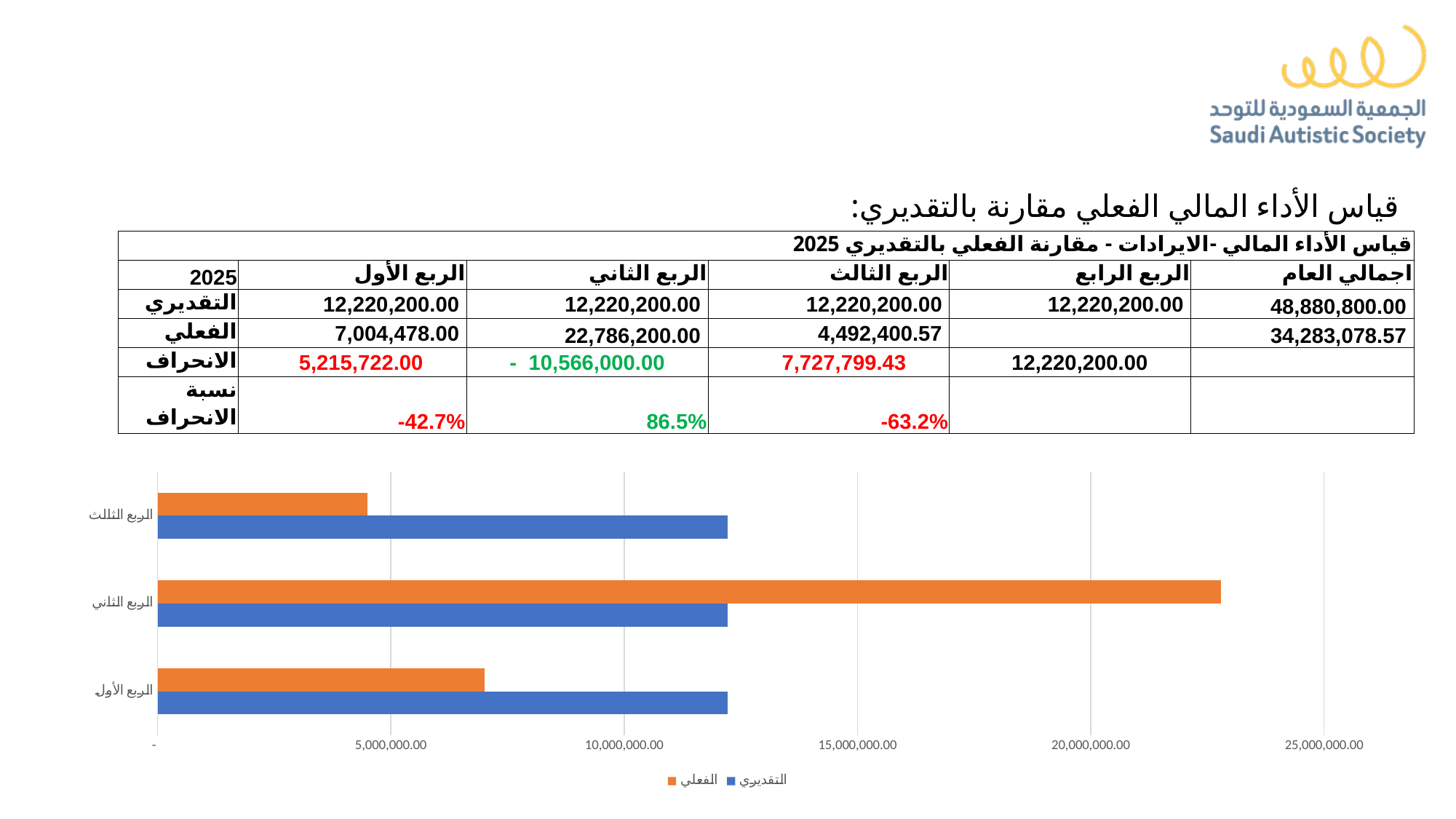
Is the الفعلي value for الربع الثالث greater or less than 5,000,000.00? less How many series does the chart legend list? 2 Is the الفعلي value for الربع الثاني greater or less than 20,000,000.00? greater How many quarters (categories) are plotted on the chart? 3 For الربع الثاني, which is larger: التقديري or الفعلي? الفعلي What is the التقديري (estimated) value for الربع الأول? 12,220,200.00 What kind of chart is shown on the slide? bar chart For الربع الأول, which is larger: التقديري or الفعلي? التقديري Which quarter has the highest الفعلي (actual) value on the chart? الربع الثاني What is the الفعلي (actual) value for الربع الثاني? 22,786,200.00 What colour are the الفعلي bars in the chart? orange Which quarter has the lowest الفعلي (actual) value on the chart? الربع الثالث